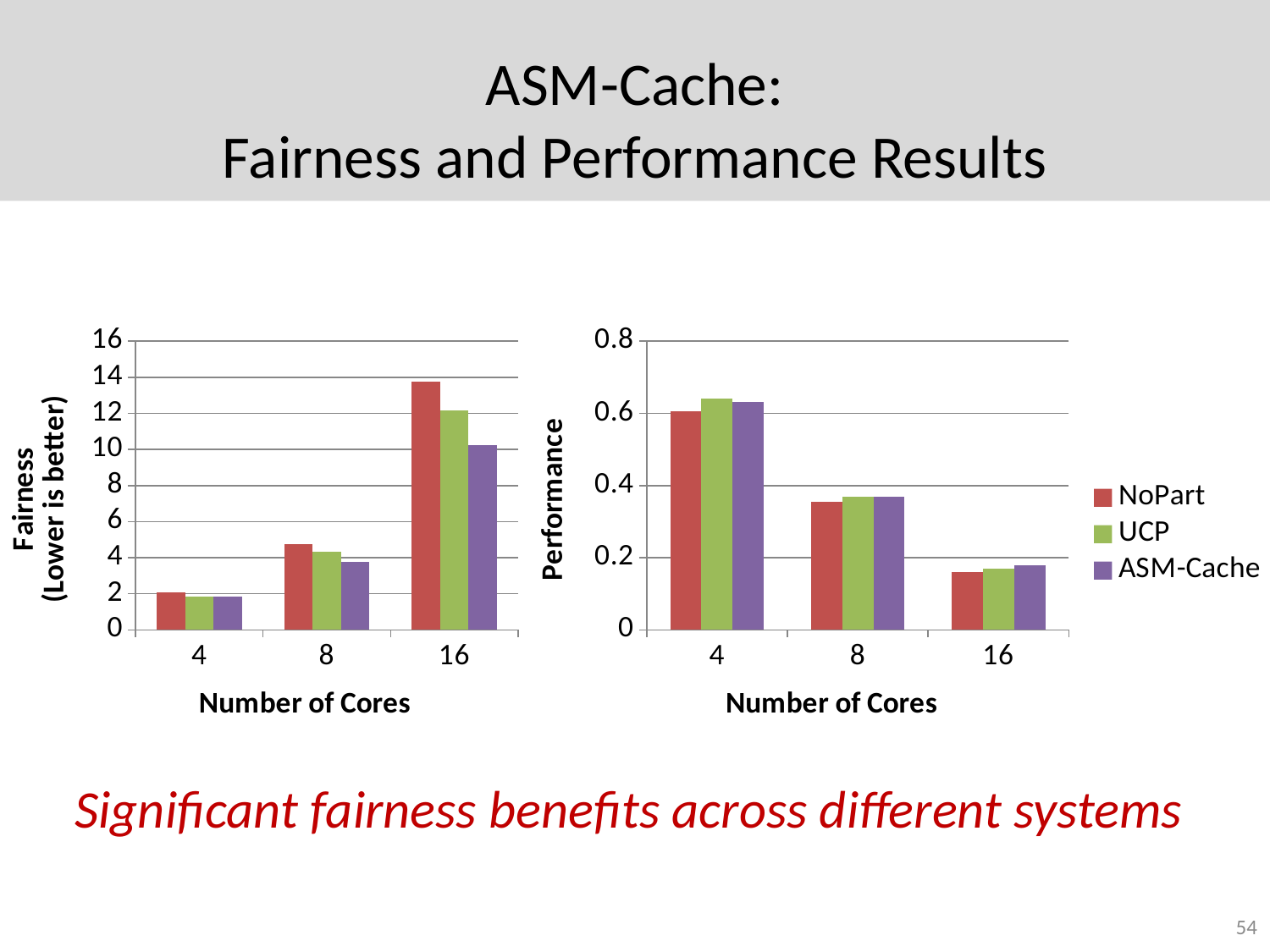
On the left chart (Fairness), do the NoPart values rise or fall as the number of cores increases? rise On the left chart (Fairness), at 8 cores, which is larger: NoPart or ASM-Cache? NoPart What kind of chart is the left chart (Fairness)? bar chart On the left chart (Fairness), at which number of cores is the NoPart value highest? 16 On the right chart (Performance), is the NoPart value at 4 cores greater or less than 0.4? greater How many Number of Cores categories are shown on the left chart (Fairness)? 3 On the left chart (Fairness), is the ASM-Cache value at 16 cores greater or less than 12? less On the right chart (Performance), at which number of cores is the ASM-Cache value highest? 4 On the right chart (Performance), do the values rise or fall as the number of cores increases? fall How many series does the legend list? 3 On the left chart (Fairness), which series has the lowest value at 16 cores? ASM-Cache On the left chart (Fairness), is the NoPart value at 16 cores greater or less than 12? greater